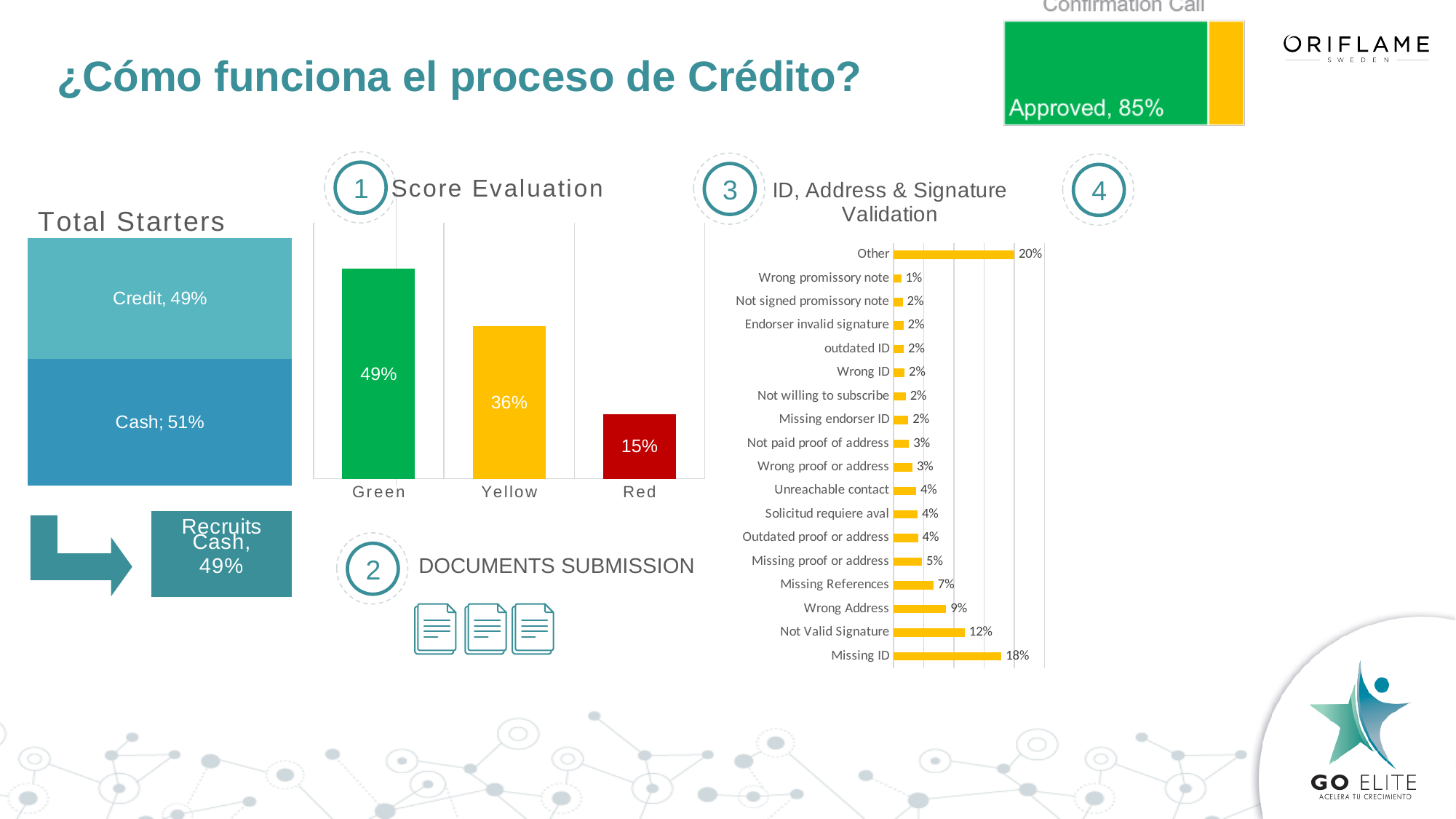
In the ID, Address & Signature Validation chart, what is the value for Not Valid Signature? 12% In the ID, Address & Signature Validation chart, what is the value for Missing ID? 18% In the Score Evaluation chart, what is the difference between the Green and Red values? 34% In the Total Starters chart, what is the value for Cash? 51% In the Score Evaluation chart, how many categories are shown? 3 In the ID, Address & Signature Validation chart, which is larger, Wrong Address or Missing References? Wrong Address In the Score Evaluation chart, what is the value for Yellow? 36% In the ID, Address & Signature Validation chart, how many categories are shown? 18 In the ID, Address & Signature Validation chart, which category has the highest value? Other In the Score Evaluation chart, what is the value for Green? 49% What kind of chart is the Score Evaluation chart? bar chart In the Score Evaluation chart, which category has the lowest value? Red